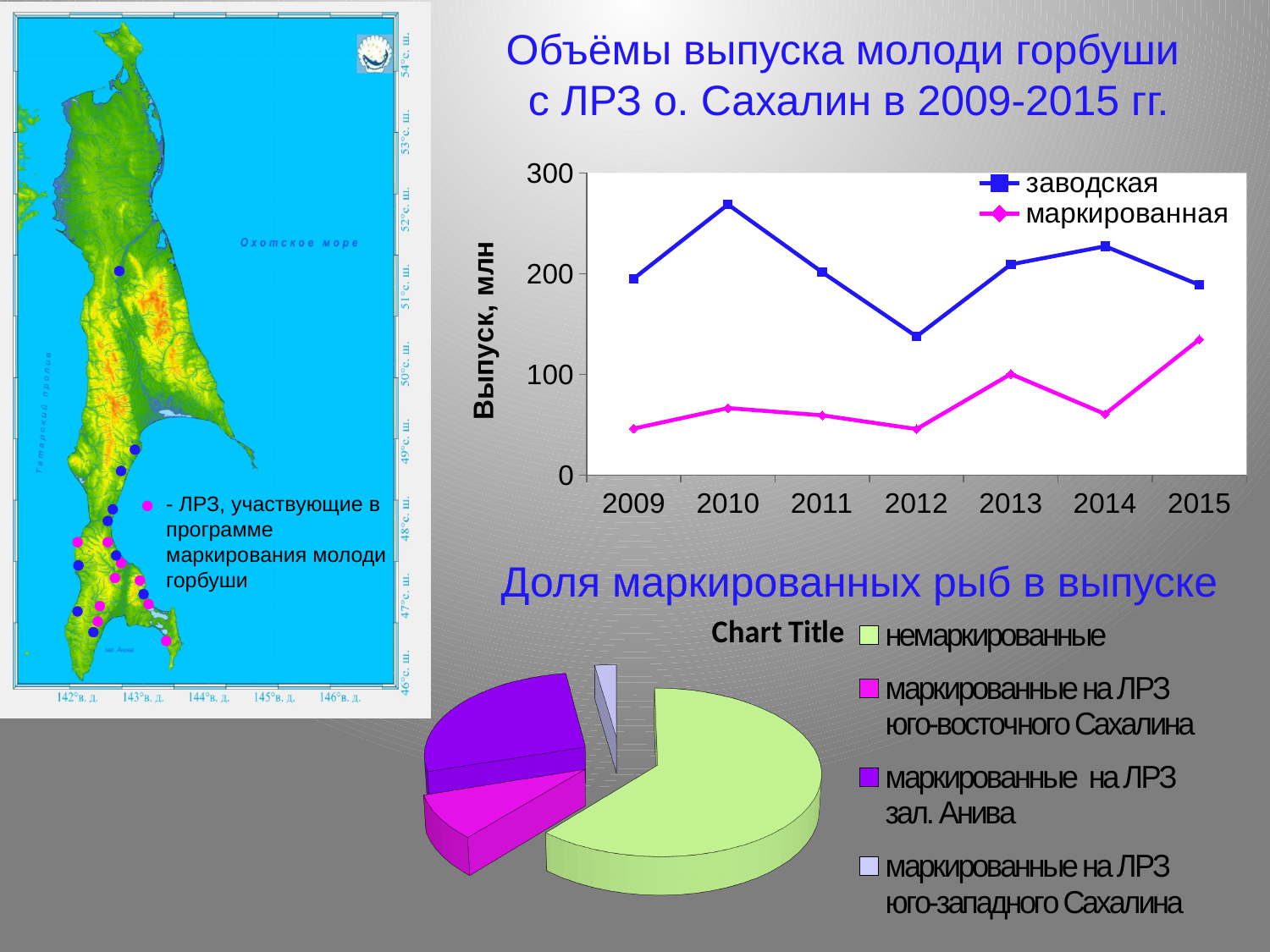
On the line chart 'Объёмы выпуска молоди горбуши', what is the label of the y axis? Выпуск, млн On the line chart 'Объёмы выпуска молоди горбуши', is the 'заводская' value for 2012 greater or less than 200? less On the line chart 'Объёмы выпуска молоди горбуши', in which year is the 'маркированная' series highest? 2015 On the line chart 'Объёмы выпуска молоди горбуши', which series has the larger value in 2012, 'заводская' or 'маркированная'? заводская On the line chart 'Объёмы выпуска молоди горбуши', is the 'заводская' value for 2010 greater or less than 200? greater On the pie chart 'Доля маркированных рыб в выпуске', which category has the largest slice? немаркированные On the line chart 'Объёмы выпуска молоди горбуши', is the 'маркированная' value for 2015 greater or less than 100? greater What kind of chart is shown under the heading 'Доля маркированных рыб в выпуске'? pie chart On the line chart 'Объёмы выпуска молоди горбуши', in which year is the 'заводская' series highest? 2010 On the line chart 'Объёмы выпуска молоди горбуши с ЛРЗ о. Сахалин в 2009-2015 гг.', how many series does the legend list? 2 On the line chart 'Объёмы выпуска молоди горбуши', in which year is the 'заводская' series lowest? 2012 On the line chart 'Объёмы выпуска молоди горбуши', how many years are shown on the x axis? 7